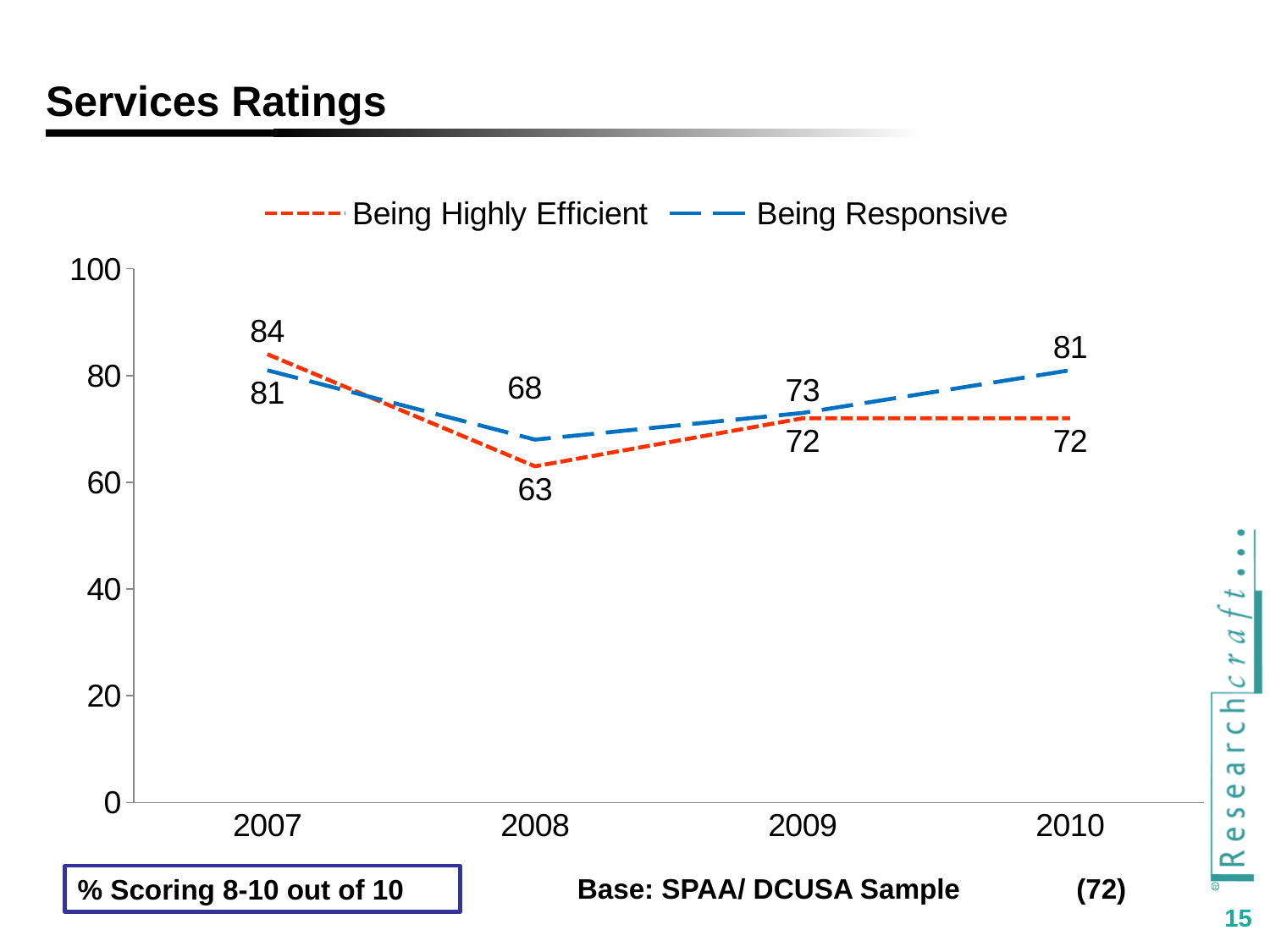
What is the value for Being Responsive in 2010? 81 How many years are shown on the x axis? 4 In which year is Being Highly Efficient highest? 2007 What is the difference between Being Responsive and Being Highly Efficient in 2010? 9 What kind of chart is shown on the slide? Line chart What is the value for Being Highly Efficient in 2007? 84 Does the value for Being Responsive rise or fall from 2008 to 2010? Rise Which series has the higher value in 2007, Being Highly Efficient or Being Responsive? Being Highly Efficient How many series does the legend list? 2 What is the value for Being Responsive in 2008? 68 What is the difference between the 2007 and 2008 values for Being Highly Efficient? 21 In which year is Being Highly Efficient lowest? 2008